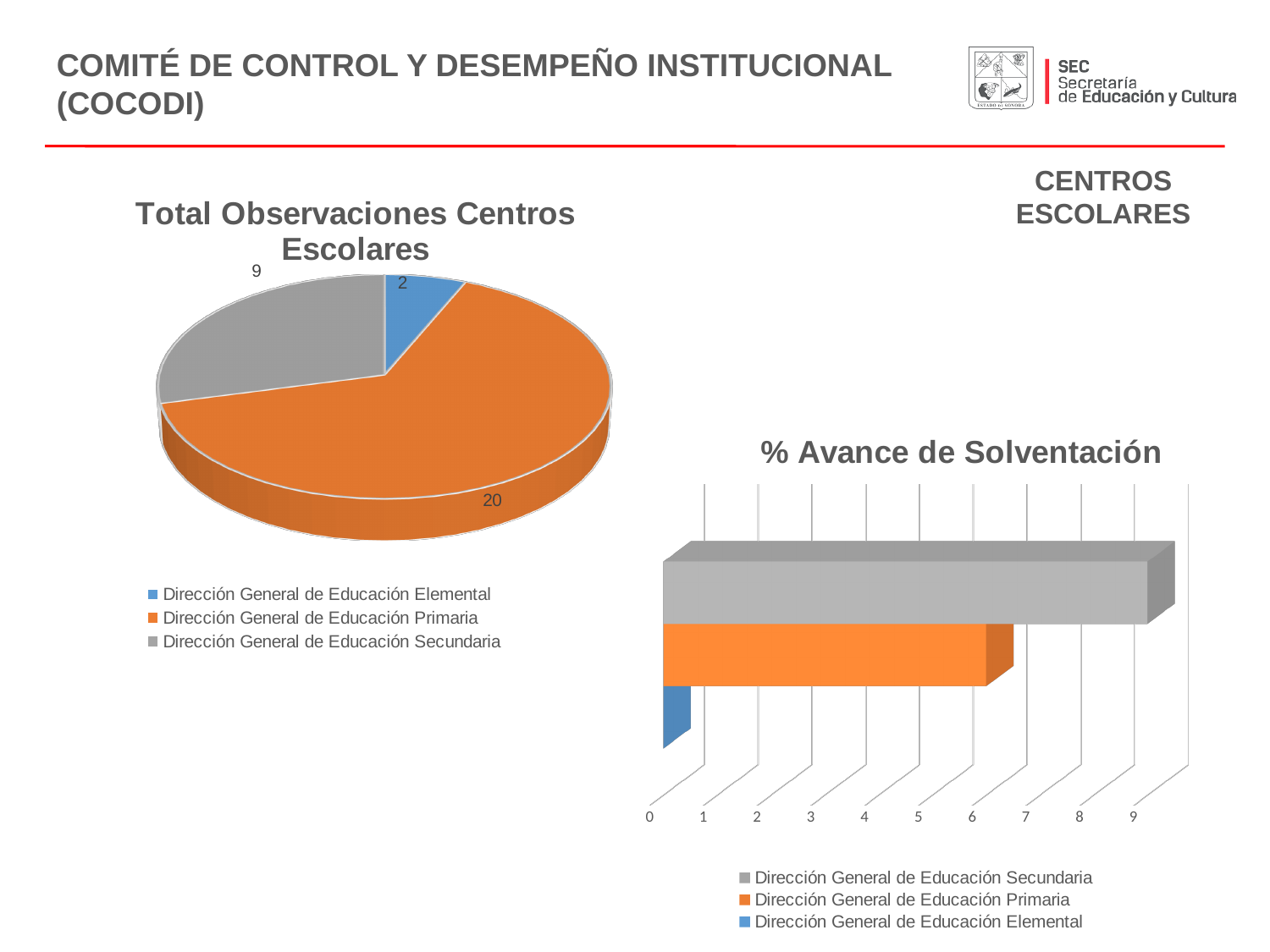
In the 'Total Observaciones Centros Escolares' chart, what is the value for Dirección General de Educación Secundaria? 9 In the 'Total Observaciones Centros Escolares' chart, what is the value for Dirección General de Educación Elemental? 2 In the 'Total Observaciones Centros Escolares' chart, what is the difference between the values for Primaria and Secundaria? 11 In the 'Total Observaciones Centros Escolares' chart, which category has the smallest slice? Dirección General de Educación Elemental In the 'Total Observaciones Centros Escolares' chart, what is the value for Dirección General de Educación Primaria? 20 What kind of chart is 'Total Observaciones Centros Escolares'? Pie chart In the '% Avance de Solventación' chart, is the value for Dirección General de Educación Primaria greater or less than 5? greater In the '% Avance de Solventación' chart, which category has the longest bar? Dirección General de Educación Secundaria In the 'Total Observaciones Centros Escolares' chart, which category has the largest slice? Dirección General de Educación Primaria How many entries does the legend of the '% Avance de Solventación' chart list? 3 What kind of chart is '% Avance de Solventación'? Bar chart In the 'Total Observaciones Centros Escolares' chart, what is the total of all slices? 31